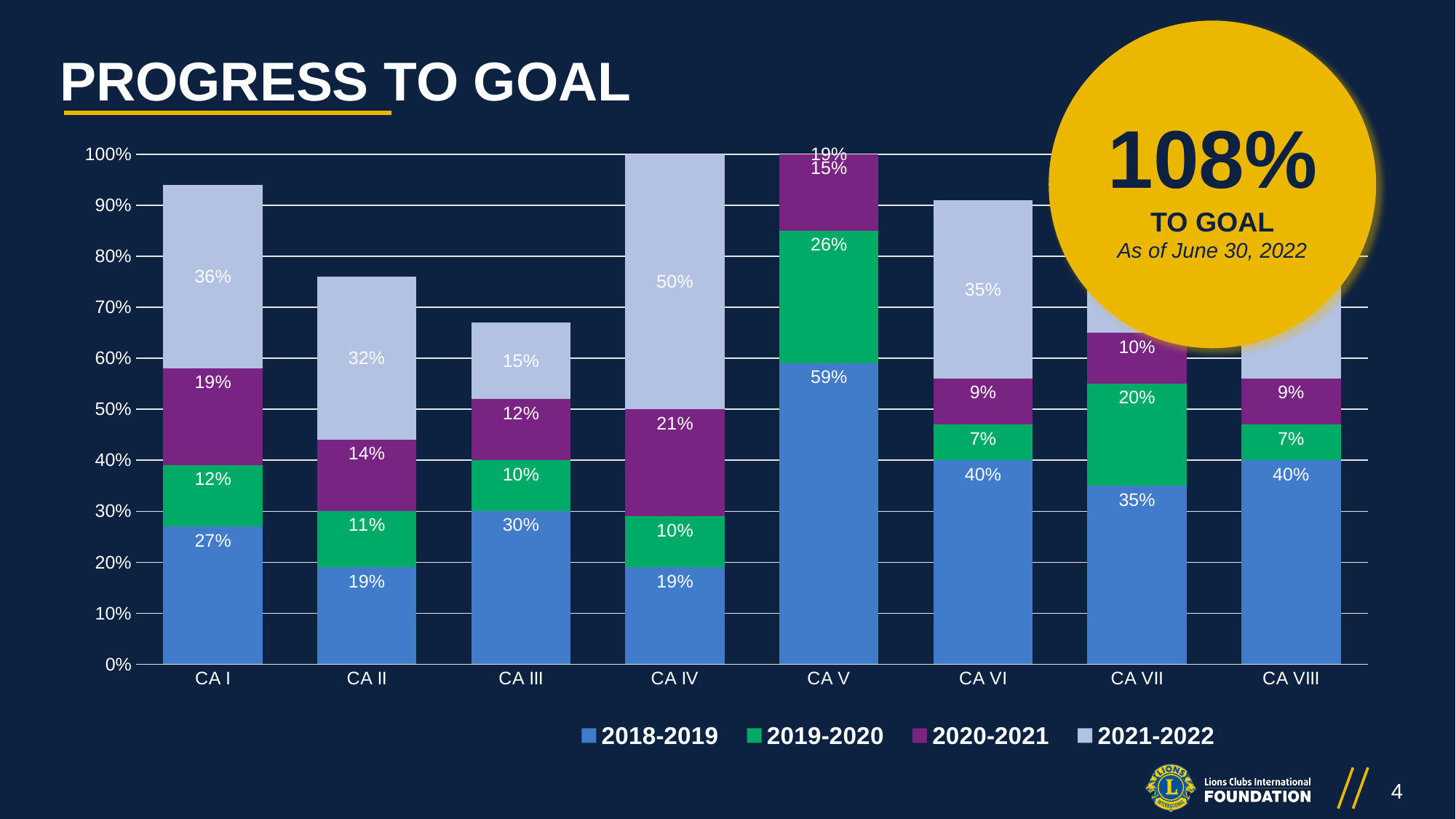
Which category has the highest 2018-2019 value? CA V What kind of chart is shown on the slide? Stacked bar chart What is the 2018-2019 value for CA I? 27% Which category has the highest 2020-2021 value? CA IV What is the 2021-2022 value for CA IV? 50% What is the 2019-2020 value for CA V? 26% What is the total of the stacked bar for CA I? 94% What is the difference between the 2021-2022 values for CA I and CA II? 4 percentage points How many series does the legend list? 4 Which is larger, the 2018-2019 value for CA III or for CA VII? CA VII How many categories (constitutional areas) are shown on the x axis? 8 What is the title of the chart? PROGRESS TO GOAL